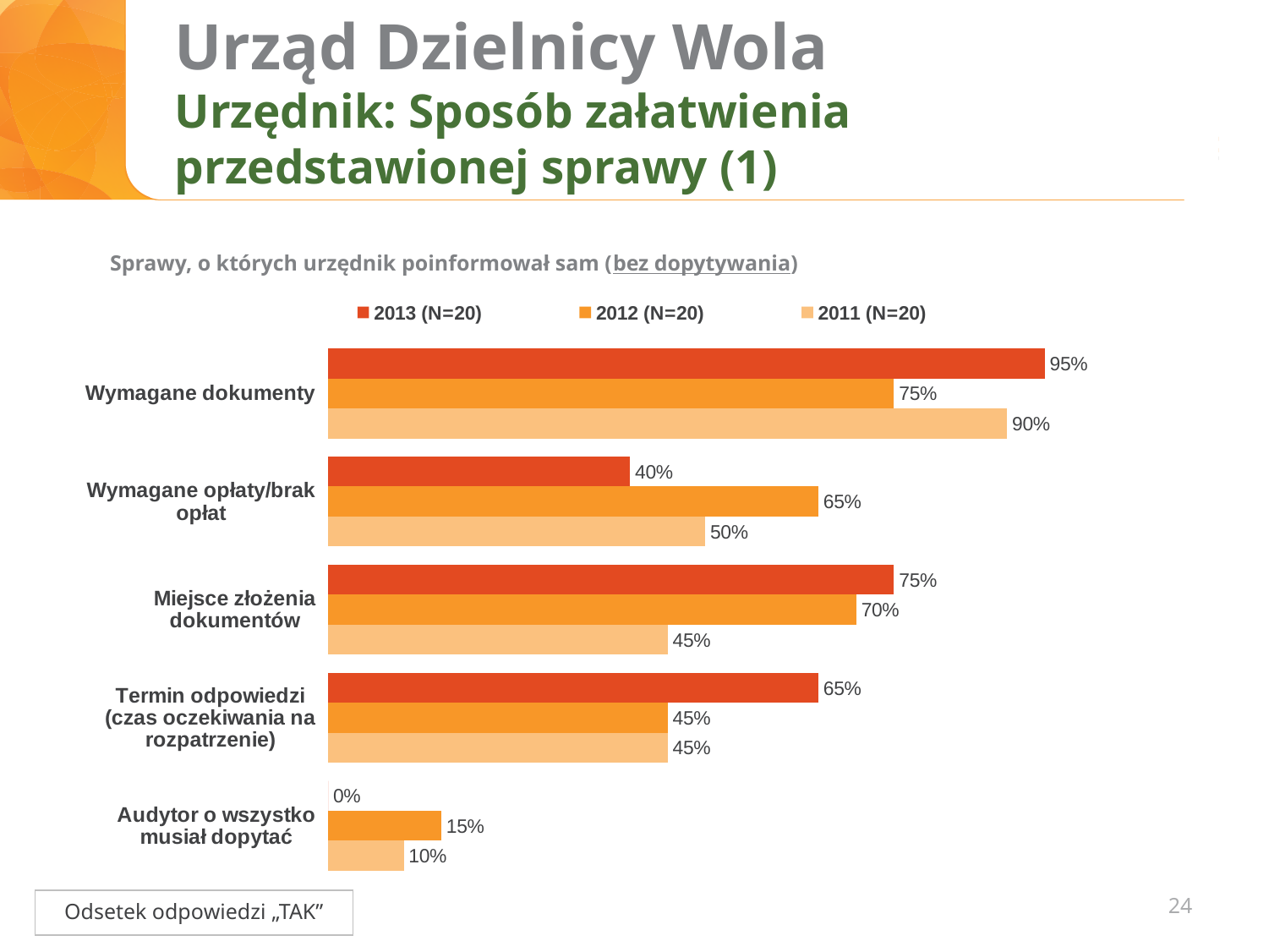
What kind of chart is shown on the slide? Bar chart Which category has the highest value in the 2013 (N=20) series? Wymagane dokumenty What is the subtitle text shown above the chart? Sprawy, o których urzędnik poinformował sam (bez dopytywania) What is the value for 'Wymagane dokumenty' in the 2013 (N=20) series? 95% What is the value for 'Miejsce złożenia dokumentów' in the 2011 (N=20) series? 45% What is the value for 'Wymagane opłaty/brak opłat' in the 2012 (N=20) series? 65% How many series does the legend list? 3 For 'Wymagane opłaty/brak opłat', which is larger: the 2013 (N=20) value or the 2011 (N=20) value? 2011 (N=20) What is the value for 'Audytor o wszystko musiał dopytać' in the 2013 (N=20) series? 0% Which category has the lowest value in the 2011 (N=20) series? Audytor o wszystko musiał dopytać How many categories are shown on the chart? 5 What is the difference between the 2013 (N=20) and 2012 (N=20) values for 'Termin odpowiedzi (czas oczekiwania na rozpatrzenie)'? 20 percentage points